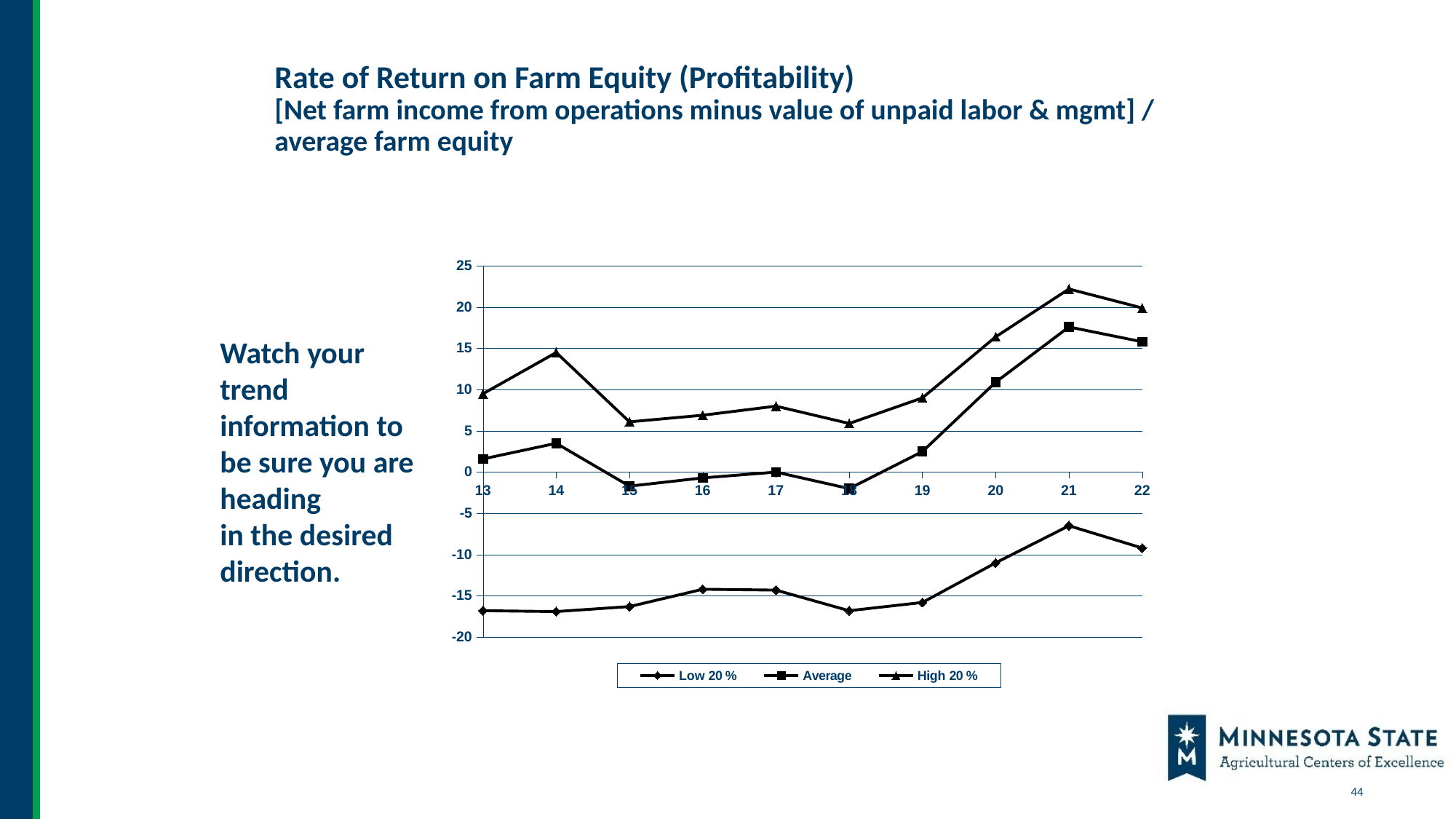
What are the three series named in the legend? Low 20 %, Average, High 20 % In which year does the High 20 % series reach its highest value? 21 How many years are plotted along the x axis? 10 In which year does the Low 20 % series reach its highest value? 21 What kind of chart is shown on the slide? line chart Is the value for Low 20 % in year 13 greater or less than -15? less How many series does the legend list? 3 Is the value for High 20 % in year 21 greater or less than 20? greater For the High 20 % series, which year has the larger value, 14 or 15? 14 In which year does the Average series reach its highest value? 21 Is the value for Average in year 21 greater or less than 15? greater Does the Average series rise or fall from year 19 to year 21? rise